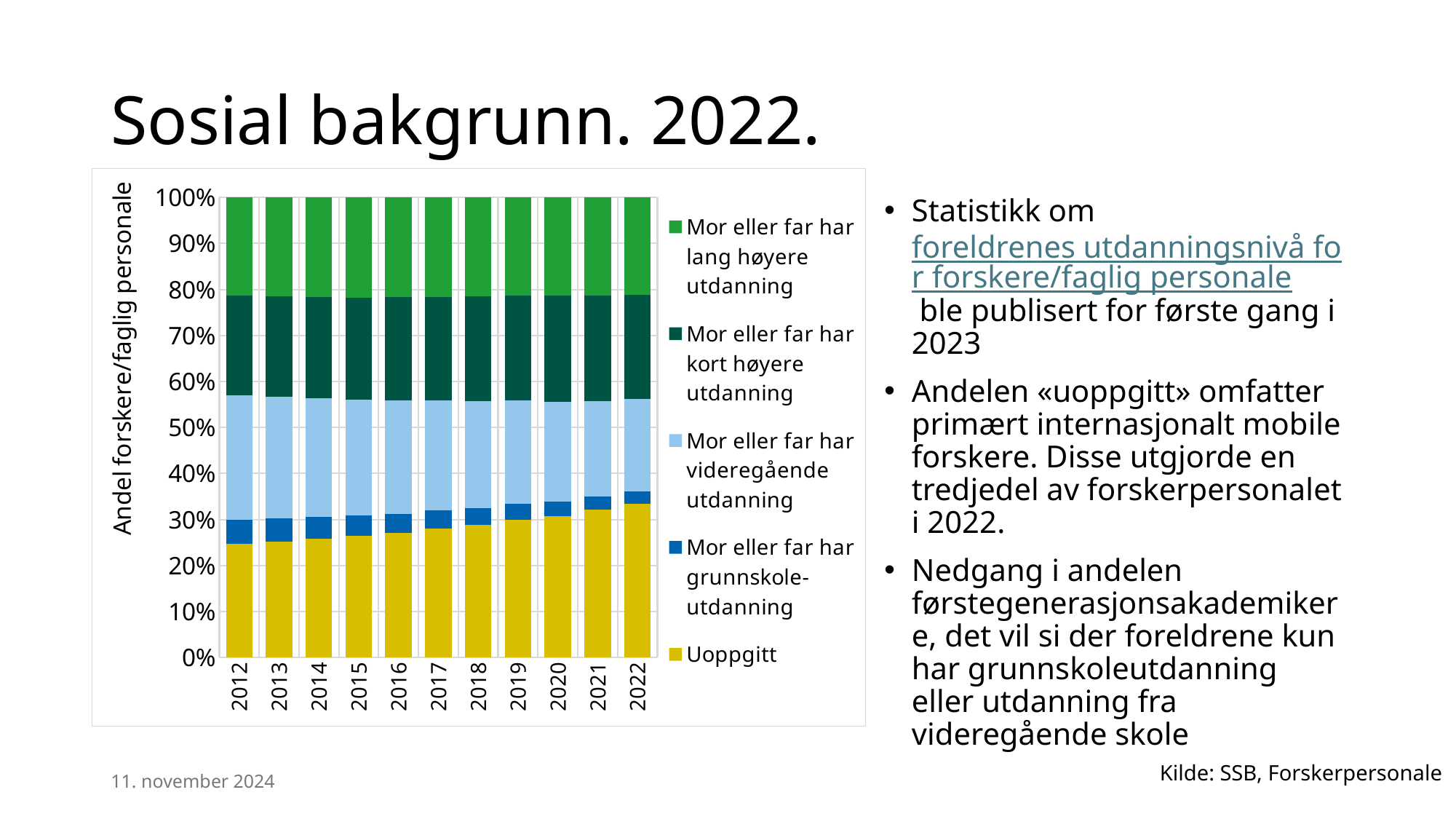
Which legend entry is shown in yellow? Uoppgitt How many years are shown along the x axis of the chart? 11 Is the value for 'Uoppgitt' in 2022 greater or less than 30%? greater What is the total height of the stacked bar for 2012? 100% What is the label of the y axis of the chart? Andel forskere/faglig personale Which year has the lowest share of 'Uoppgitt'? 2012 Which year has the highest share of 'Uoppgitt'? 2022 Is the share of 'Uoppgitt' larger in 2012 or in 2022? 2022 How many series does the chart's legend list? 5 Does the share of 'Uoppgitt' rise or fall from 2012 to 2022? Rise What kind of chart is shown on the slide? Stacked bar chart Is the value for 'Uoppgitt' in 2012 greater or less than 30%? less